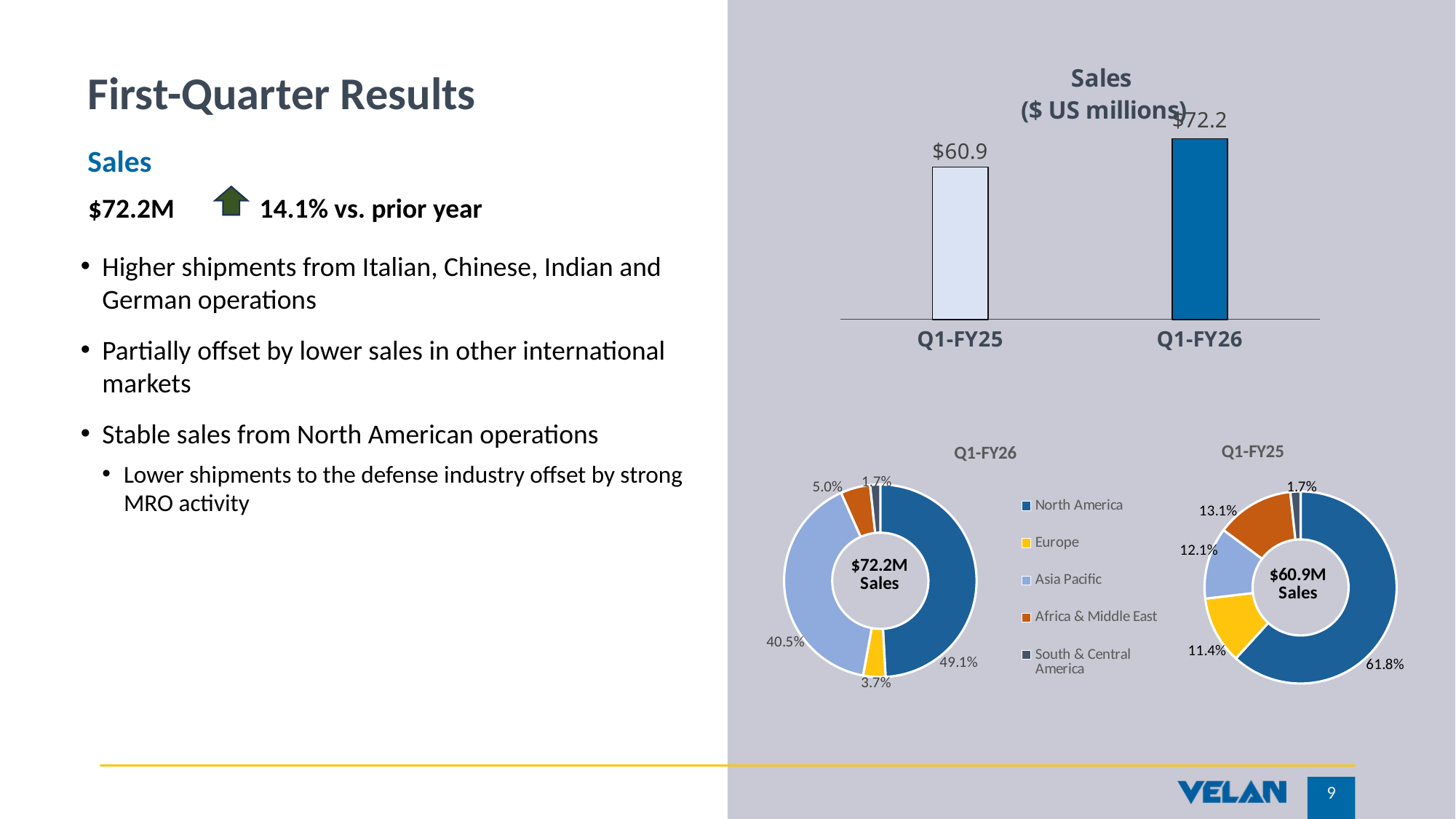
In the Q1-FY25 donut chart, what share of sales comes from Africa & Middle East? 13.1% How many regions does the legend shared by the two donut charts list? 5 Which is larger: the North America share in the Q1-FY25 donut chart or in the Q1-FY26 donut chart? Q1-FY25 In the Q1-FY25 donut chart, which region has the largest share of sales? North America In the Q1-FY26 donut chart, what share of sales comes from Asia Pacific? 40.5% In the 'Sales ($ US millions)' bar chart, what is the value for Q1-FY26? $72.2 In the 'Sales ($ US millions)' bar chart, what is the difference between Q1-FY26 and Q1-FY25 sales? $11.3 How many bars are in the 'Sales ($ US millions)' bar chart? 2 In the Q1-FY26 donut chart, what share of sales comes from Europe? 3.7% What kind of chart is the 'Sales ($ US millions)' chart? Bar chart In the 'Sales ($ US millions)' bar chart, which quarter has the higher sales? Q1-FY26 In the 'Sales ($ US millions)' bar chart, what is the value for Q1-FY25? $60.9